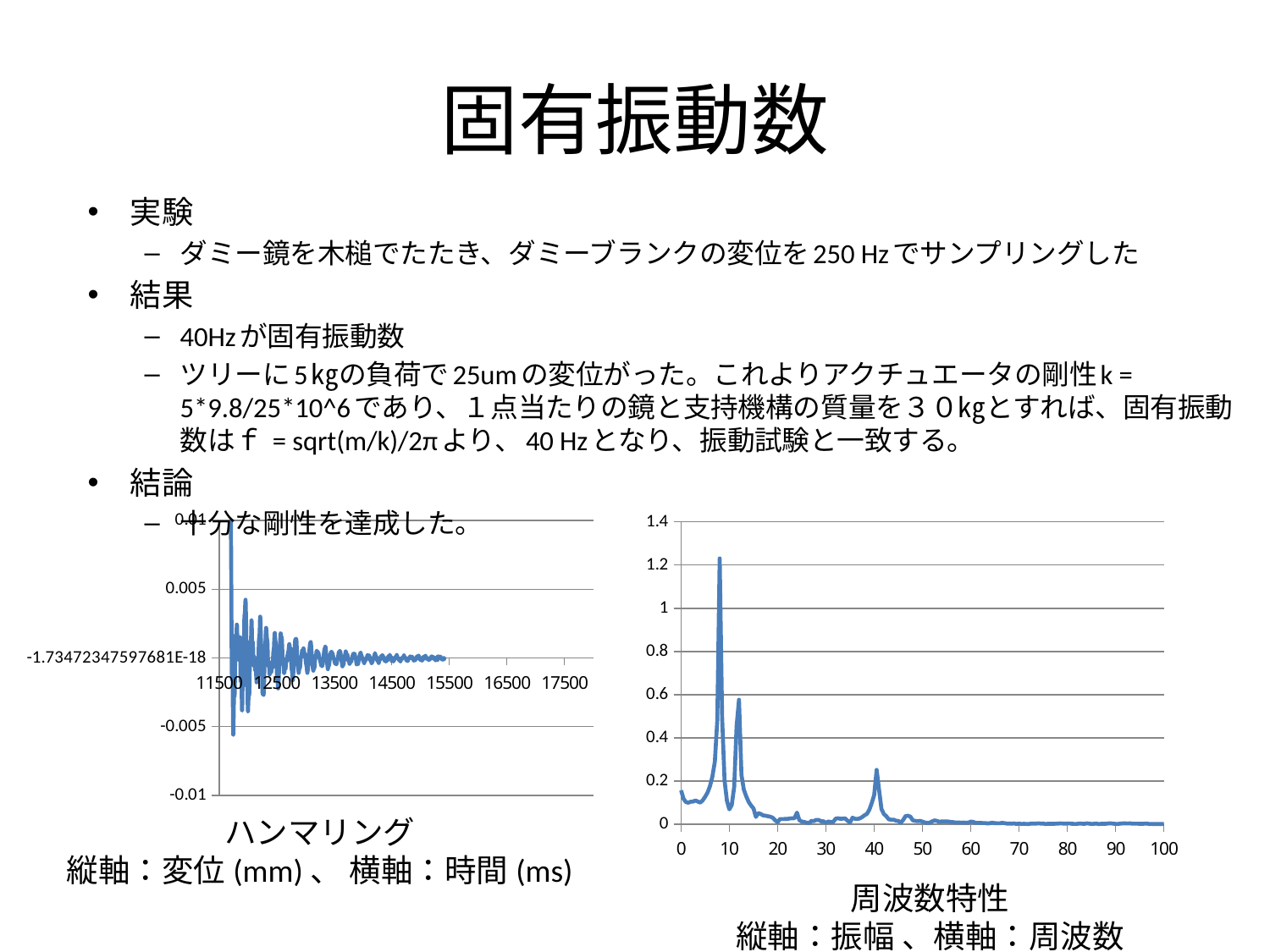
In the right chart (周波数特性), is the value of the second peak near 12 on the x axis greater or less than 0.4? greater In the right chart (周波数特性), which is larger: the peak near 10 on the x axis or the peak near 40 on the x axis? the peak near 10 What kind of chart is the left chart titled ハンマリング? line chart According to the caption of the left chart (ハンマリング), what does the horizontal axis represent? 時間 (ms) What is the highest tick value shown on the x axis of the right chart (周波数特性)? 100 What kind of chart is the right chart titled 周波数特性? line chart In the right chart (周波数特性), is the value of the peak near 40 on the x axis greater or less than 0.4? less In the right chart (周波数特性), do the values generally rise or fall as the x axis goes from 50 to 100? fall In the right chart (周波数特性), is the value of the tallest peak greater or less than 1? greater In the left chart (ハンマリング), does the amplitude of the oscillation grow or decay as time increases along the x axis? decay